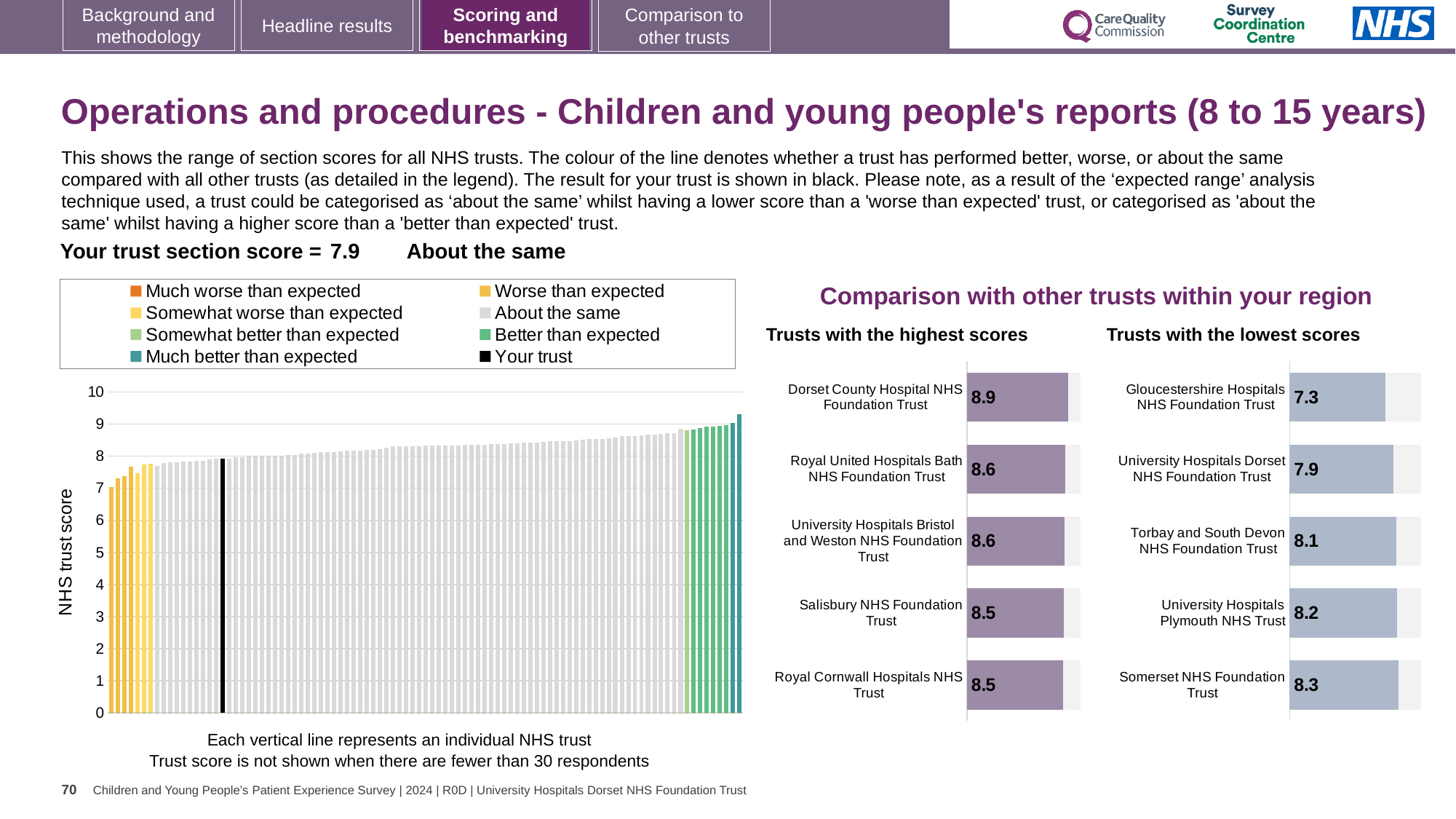
In the 'Trusts with the lowest scores' chart, what is the score for Gloucestershire Hospitals NHS Foundation Trust? 7.3 In the 'Trusts with the highest scores' chart, what is the difference between the scores of Dorset County Hospital NHS Foundation Trust and Salisbury NHS Foundation Trust? 0.4 In the large 'NHS trust score' chart on the left, do the bar values rise or fall from left to right? Rise In the 'Trusts with the lowest scores' chart, which trust has the lowest score? Gloucestershire Hospitals NHS Foundation Trust In the large 'NHS trust score' chart on the left, is the value of the tallest bar greater or less than 9? greater In the 'Trusts with the highest scores' chart, what is the score for Dorset County Hospital NHS Foundation Trust? 8.9 What kind of chart is the large 'NHS trust score' chart on the left of the slide? Bar chart In the 'Trusts with the lowest scores' chart, which has the higher score: Torbay and South Devon NHS Foundation Trust or University Hospitals Plymouth NHS Trust? University Hospitals Plymouth NHS Trust How many entries does the legend above the large 'NHS trust score' chart list? 8 In the 'Trusts with the highest scores' chart, which trust has the highest score? Dorset County Hospital NHS Foundation Trust How many trusts are shown in the 'Trusts with the highest scores' chart? 5 In the 'Trusts with the lowest scores' chart, what is the difference between the scores of Somerset NHS Foundation Trust and Gloucestershire Hospitals NHS Foundation Trust? 1.0